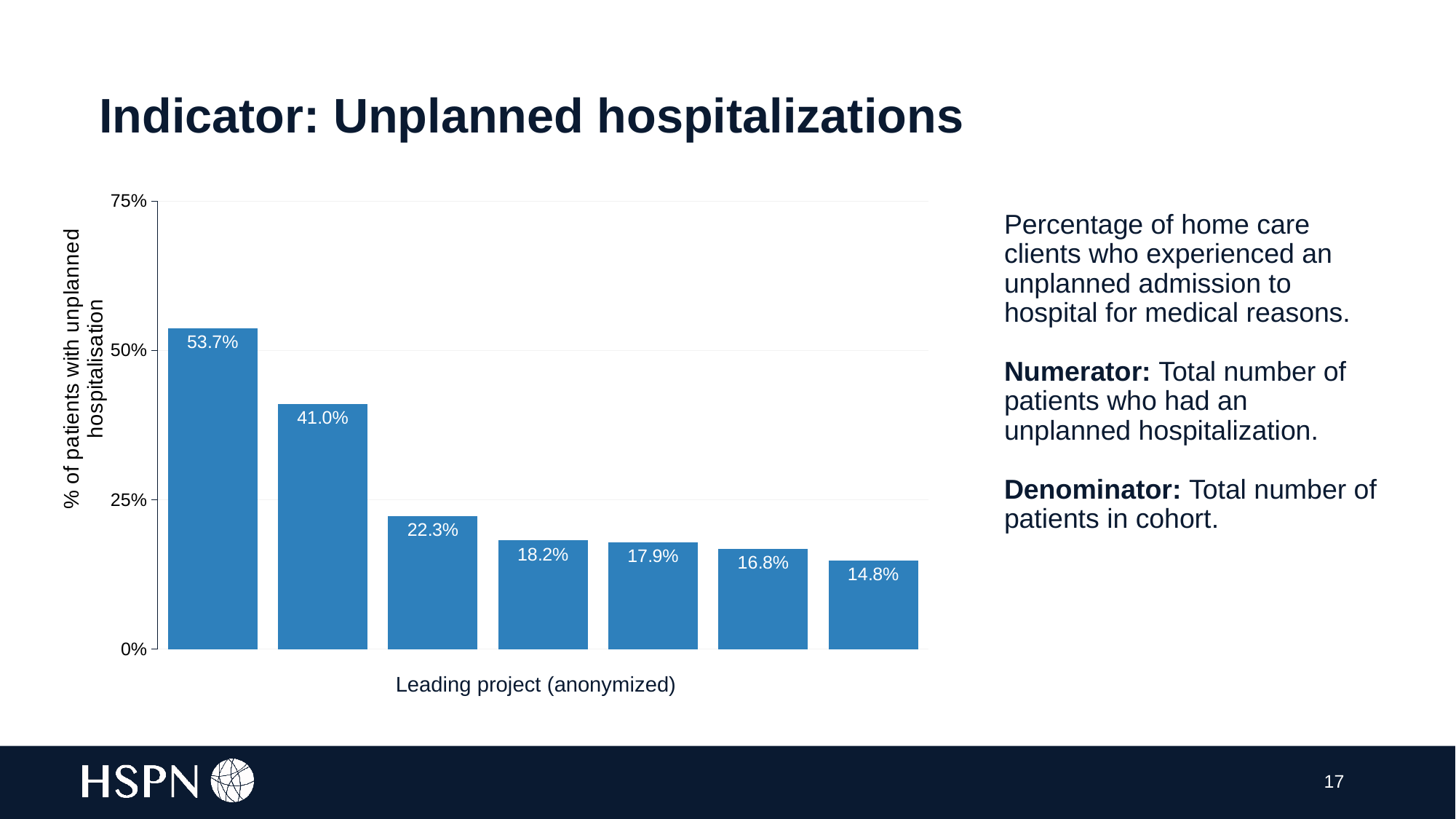
What is the value of the tallest bar in the chart? 53.7% How many bars are plotted in the chart? 7 What is the label on the x axis of the chart? Leading project (anonymized) What is the value shown on the third bar from the left? 22.3% What is the value shown on the fifth bar from the left? 17.9% What is the value of the shortest bar in the chart? 14.8% Which is larger, the value of the first bar or the value of the second bar? The first bar (53.7%) What is the difference between the first bar (53.7%) and the second bar (41.0%)? 12.7% What kind of chart is shown on the slide? Bar chart Do the bar values rise or fall from left to right across the chart? Fall What is the value shown on the second bar from the left? 41.0% What is the difference between the third bar (22.3%) and the last bar (14.8%)? 7.5%